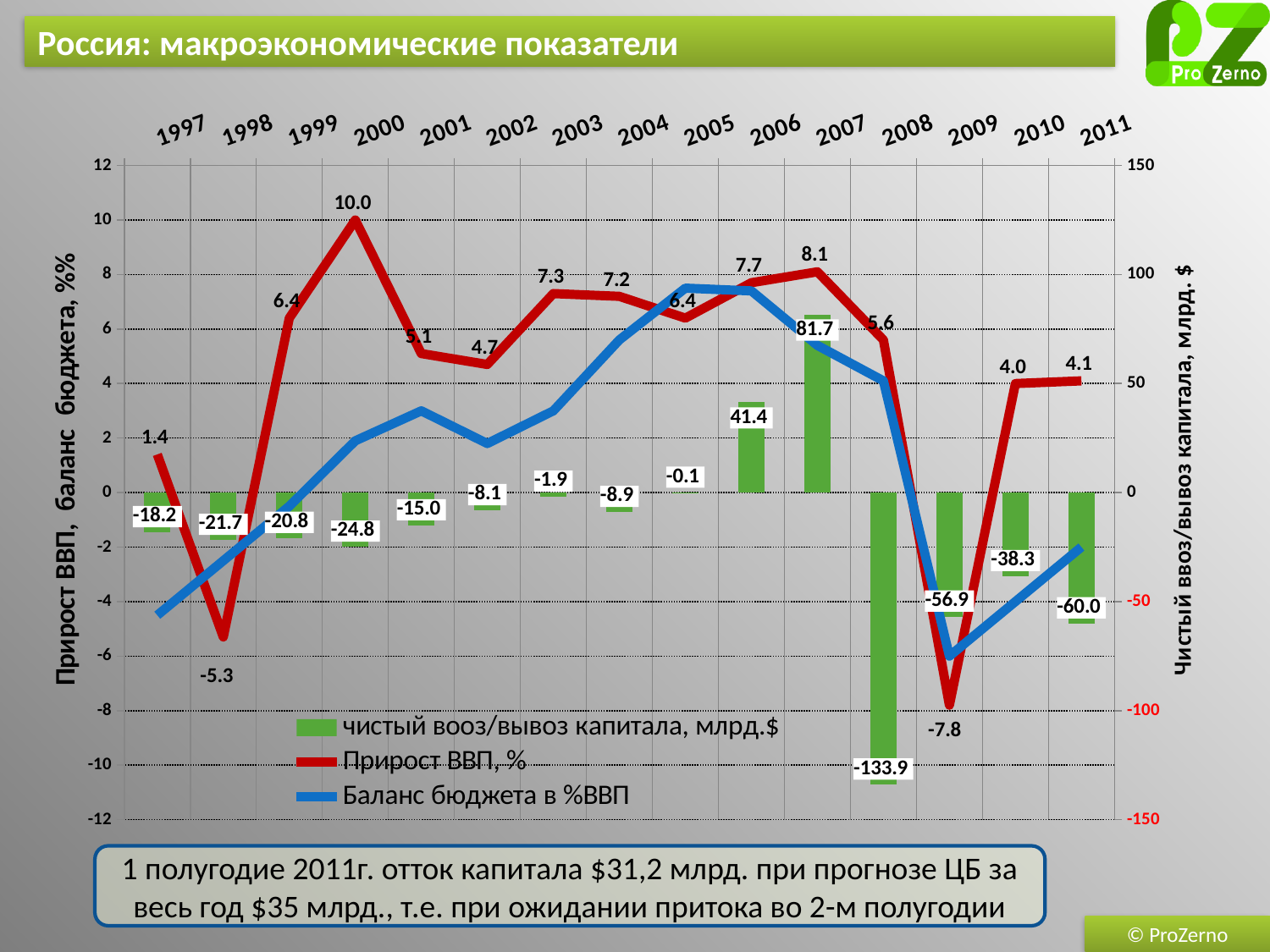
What is the difference between GDP growth in 2007 (8.1) and in 2008 (5.6)? 2.5 In which year was GDP growth the highest? 2000 What was the net capital inflow/outflow in 2007? 81.7 Is the budget balance (Баланс бюджета в %ВВП) in 2009 greater or less than -4? less What was the net capital inflow/outflow (чистый ввоз/вывоз капитала, млрд.$) in 2008? -133.9 What kind of chart is this? Combined bar and line chart In which year was the net capital outflow the largest (lowest bar)? 2008 What was GDP growth (Прирост ВВП, %) in 2000? 10.0 How many series does the legend list? 3 How many years are shown on the x axis? 15 Which year had higher GDP growth, 2003 or 2004? 2003 In which year was GDP growth the lowest? 2009